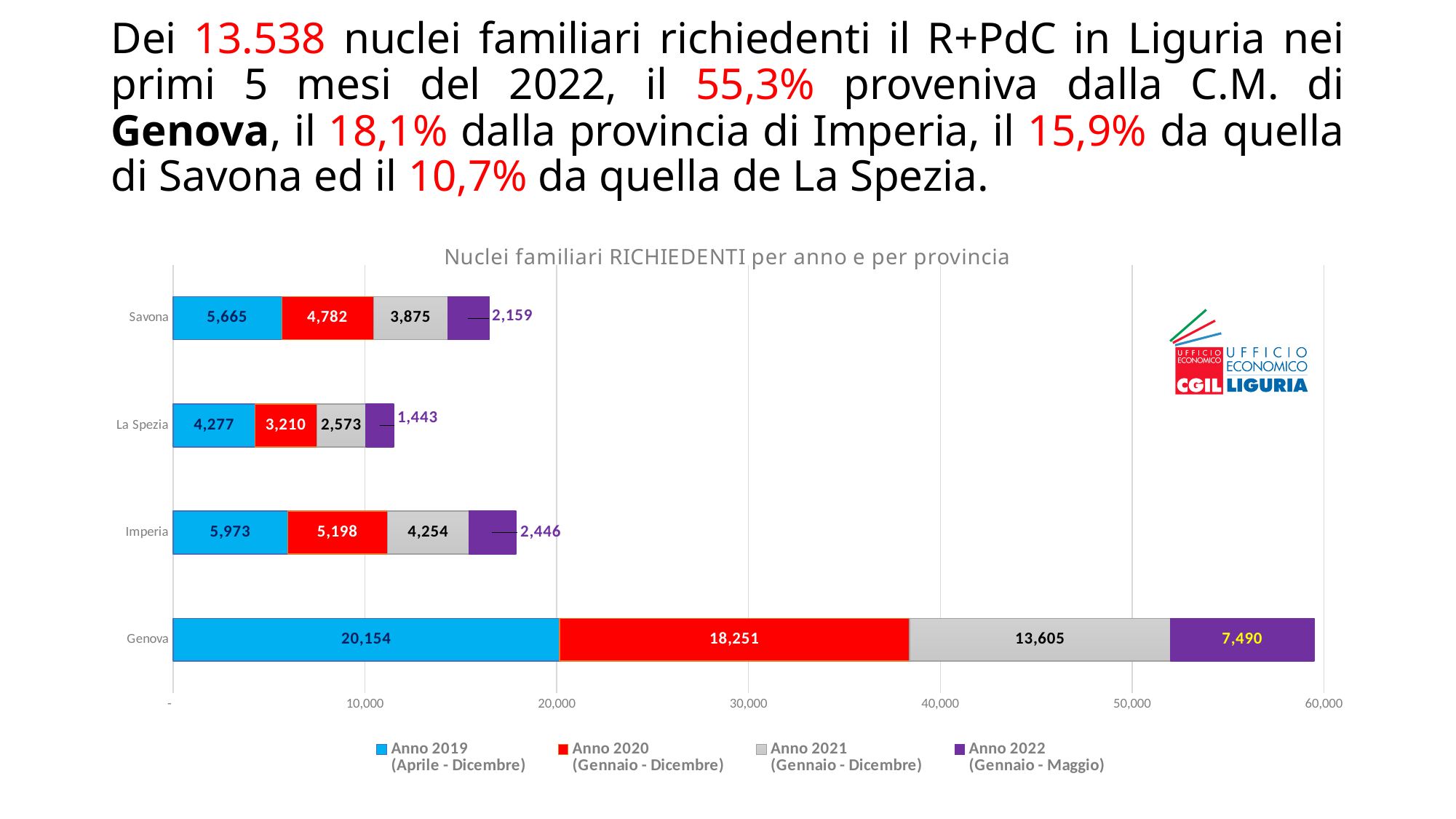
How many series does the legend list? 4 What is the total of the stacked bar for La Spezia? 11,503 What is the value for Genova in the Anno 2019 (Aprile - Dicembre) series? 20,154 How many provinces are shown on the chart? 4 Which province has the lowest value in the Anno 2022 (Gennaio - Maggio) series? La Spezia What is the total of the stacked bar for Genova? 59,500 Which is larger: the Anno 2021 value for Savona or the Anno 2021 value for Imperia? Imperia What is the value for Imperia in the Anno 2021 (Gennaio - Dicembre) series? 4,254 What kind of chart is shown on the slide? Stacked bar chart What is the difference between the Anno 2019 and Anno 2020 values for Savona? 883 What is the value for La Spezia in the Anno 2022 (Gennaio - Maggio) series? 1,443 Which province has the highest value in the Anno 2020 (Gennaio - Dicembre) series? Genova